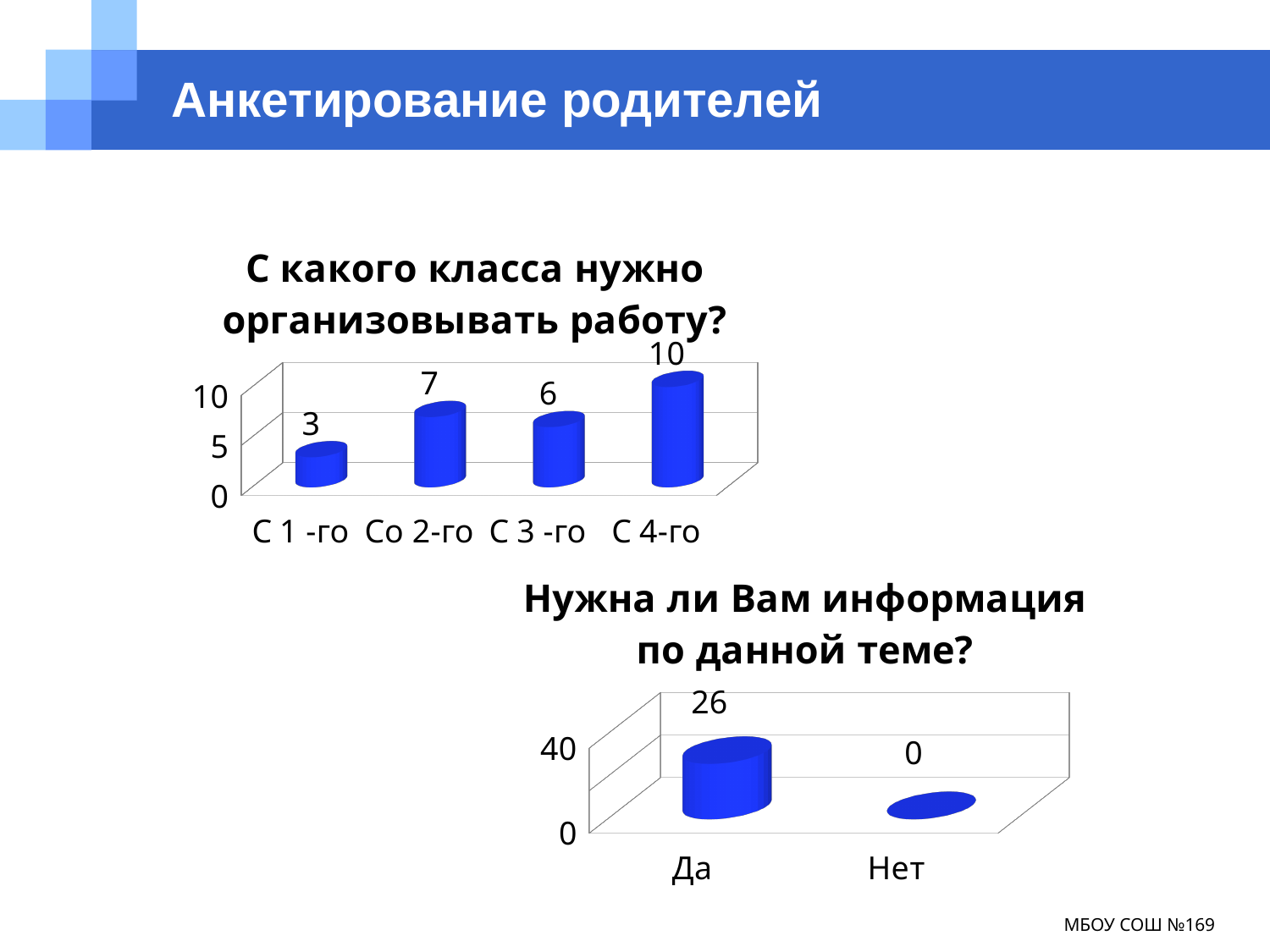
How many categories are shown in the chart titled 'С какого класса нужно организовывать работу?'? 4 In the chart titled 'Нужна ли Вам информация по данной теме?', what is the value for 'Да'? 26 In the chart titled 'С какого класса нужно организовывать работу?', what is the value for 'С 1 -го'? 3 In the chart titled 'С какого класса нужно организовывать работу?', which category has the highest value? С 4-го How many categories are shown in the chart titled 'Нужна ли Вам информация по данной теме?'? 2 What kind of chart is the chart titled 'Нужна ли Вам информация по данной теме?'? bar chart In the chart titled 'С какого класса нужно организовывать работу?', what is the value for 'Со 2-го'? 7 In the chart titled 'С какого класса нужно организовывать работу?', which category has the lowest value? С 1 -го In the chart titled 'Нужна ли Вам информация по данной теме?', what is the value for 'Нет'? 0 In the chart titled 'Нужна ли Вам информация по данной теме?', what is the difference between the values for 'Да' and 'Нет'? 26 In the chart titled 'С какого класса нужно организовывать работу?', which is larger: the value for 'Со 2-го' or 'С 3 -го'? Со 2-го In the chart titled 'С какого класса нужно организовывать работу?', what is the difference between the values for 'С 4-го' and 'С 3 -го'? 4